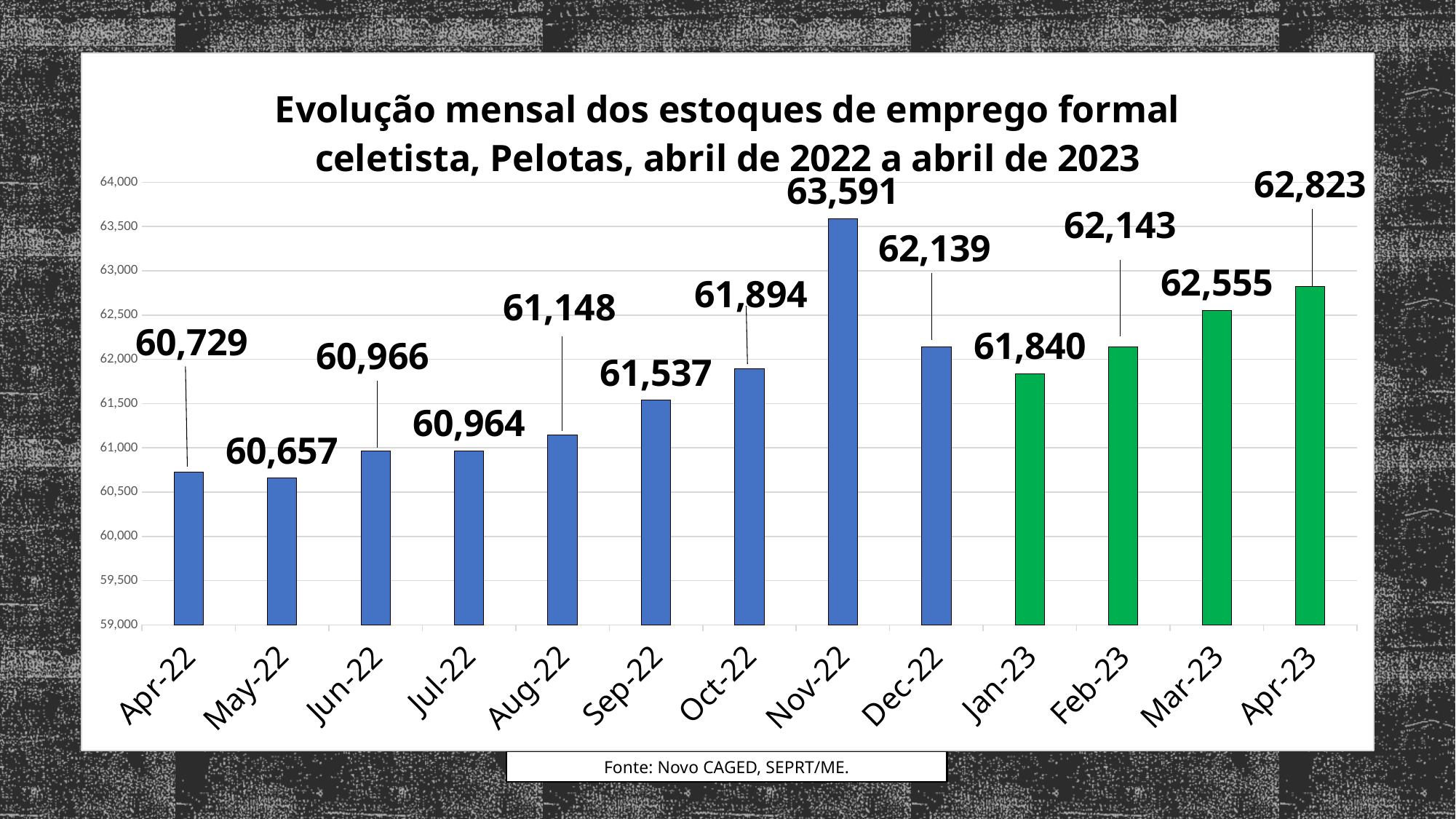
What is the value for Nov-22? 63,591 Which month has the lowest value? May-22 Is the value for Jan-23 greater or less than 62,000? less What is the difference between the values for Nov-22 and Dec-22? 1,452 How many months are shown on the x axis? 13 What is the value for Jan-23? 61,840 What is the value for Apr-23? 62,823 What colour are the bars for the 2023 months? green What kind of chart is shown on the slide? bar chart Which month has the highest value? Nov-22 What is the difference between the values for Apr-23 and Apr-22? 2,094 Which is larger, the value for Mar-23 or the value for Oct-22? Mar-23